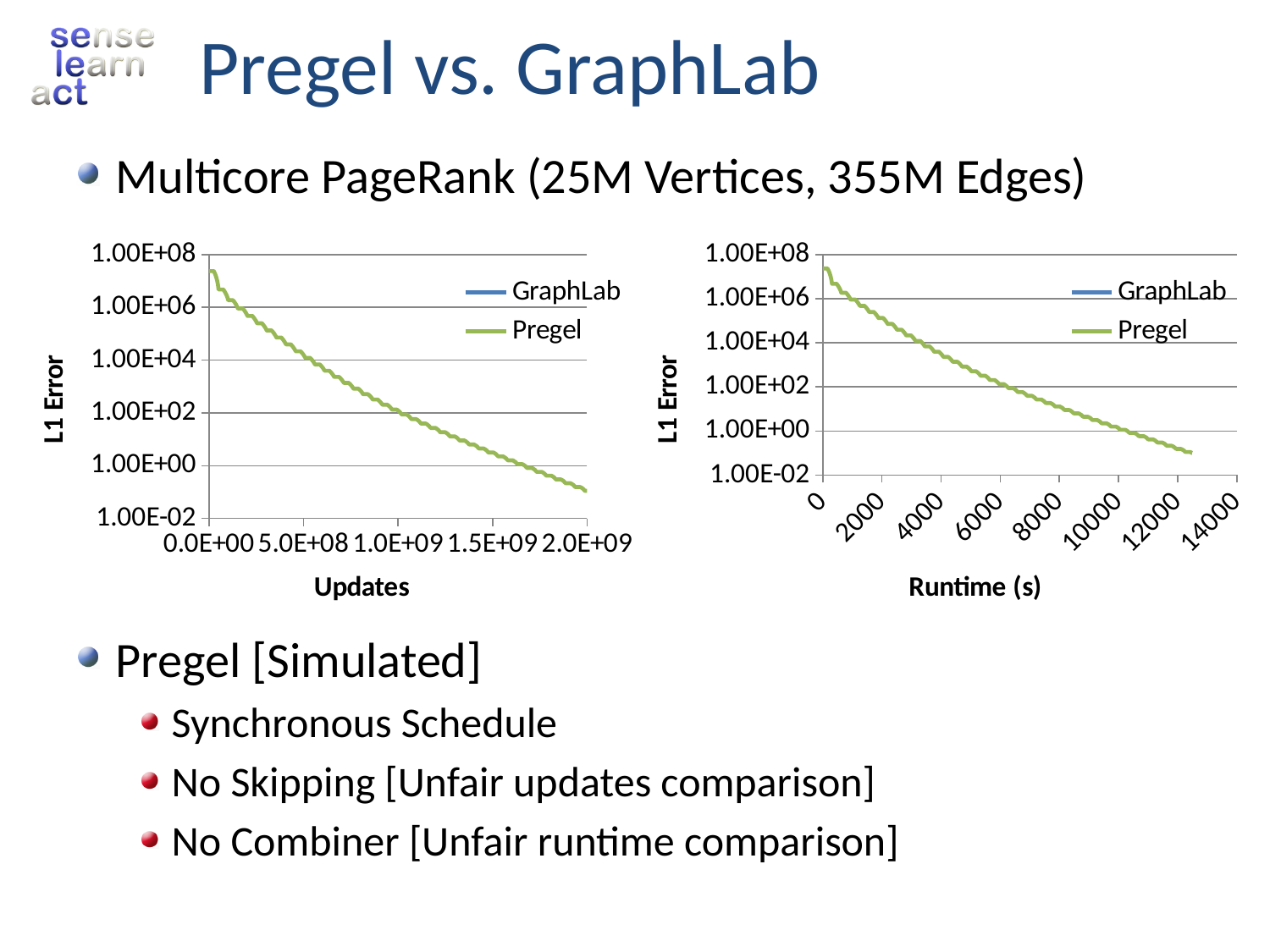
In the right chart, is the Pregel L1 Error at a runtime of 12000 s greater or less than 1.00E+00? less In the left chart, does the Pregel L1 Error rise or fall as Updates increase? fall How many series does the legend of the right chart list? 2 In the right chart, is the Pregel L1 Error at a runtime of 8000 s greater or less than 1.00E+02? less What is the x-axis title of the left chart? Updates What is the x-axis title of the right chart? Runtime (s) What kind of chart is the left chart (L1 Error vs. Updates)? line chart In the right chart, does the Pregel L1 Error rise or fall as Runtime increases? fall What kind of chart is the right chart (L1 Error vs. Runtime)? line chart How many series does the legend of the left chart list? 2 In the right chart, is the Pregel L1 Error at a runtime of 2000 s greater or less than 1.00E+04? greater